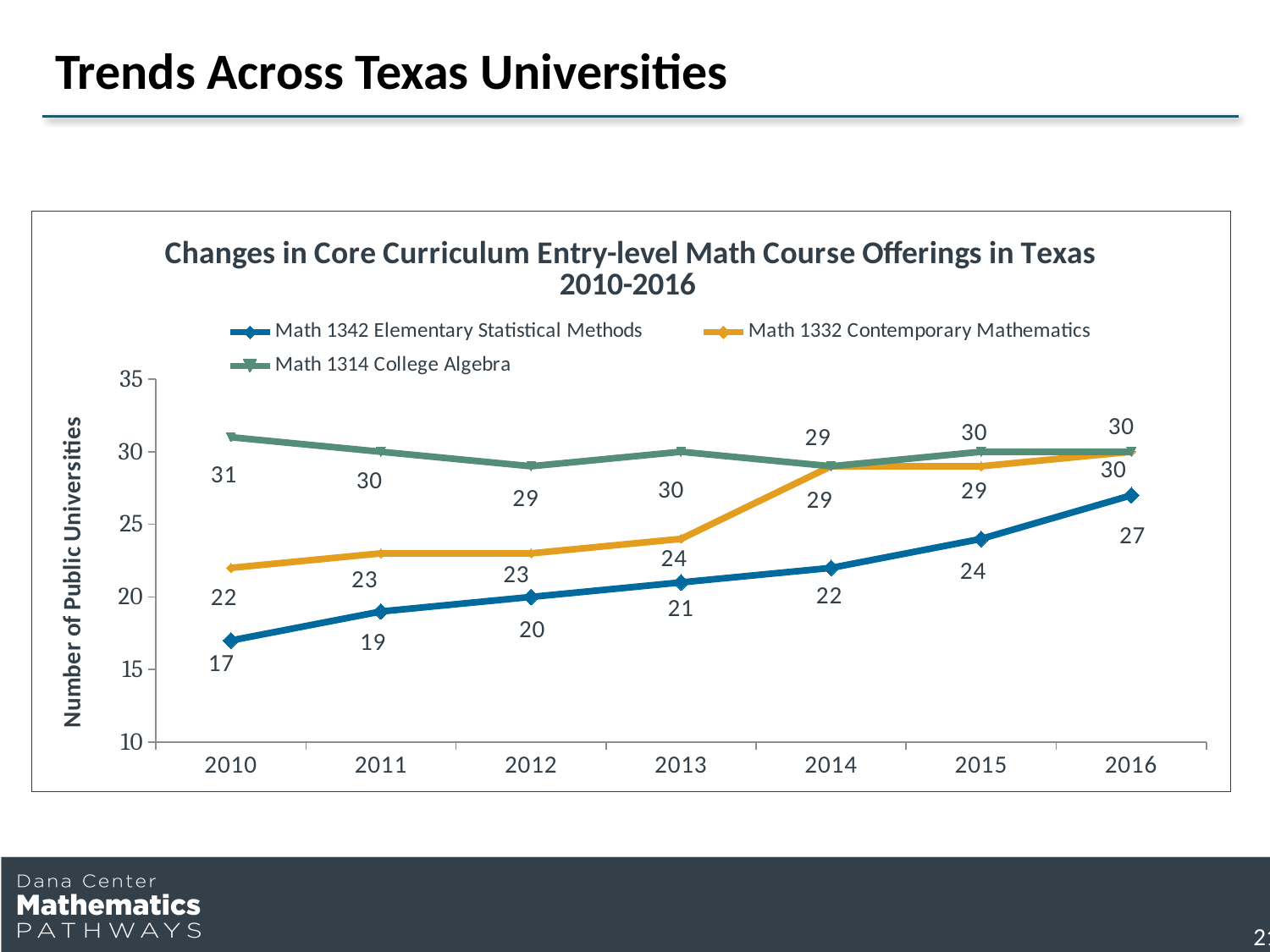
What is the difference between the Math 1342 Elementary Statistical Methods values in 2016 and 2010? 10 How many years are plotted along the x axis? 7 In which year is the value for Math 1332 Contemporary Mathematics lowest? 2010 Does the value for Math 1342 Elementary Statistical Methods rise or fall from 2010 to 2016? rise What is the value for Math 1314 College Algebra in 2012? 29 Which series has the larger value in 2011, Math 1332 Contemporary Mathematics or Math 1342 Elementary Statistical Methods? Math 1332 Contemporary Mathematics What is the value for Math 1342 Elementary Statistical Methods in 2010? 17 How many series does the legend list? 3 What is the value for Math 1332 Contemporary Mathematics in 2013? 24 What type of chart is shown on the slide? line chart In which year is the value for Math 1342 Elementary Statistical Methods highest? 2016 What is the title of the chart? Changes in Core Curriculum Entry-level Math Course Offerings in Texas 2010-2016